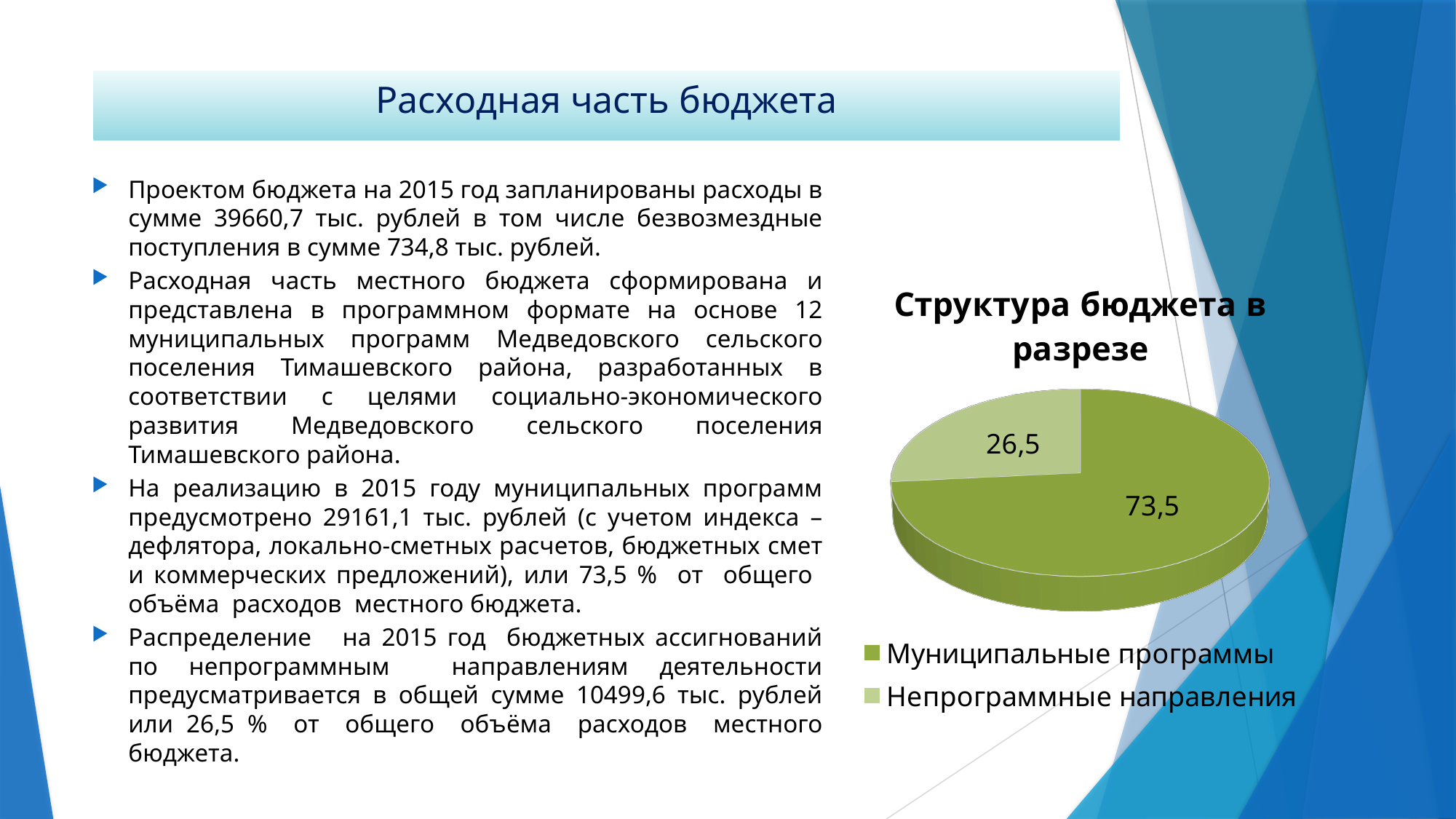
What value is shown for Непрограммные направления in the pie chart? 26,5 Which is larger: Муниципальные программы or Непрограммные направления? Муниципальные программы Which slice of the pie chart is the largest? Муниципальные программы What is the title of the chart? Структура бюджета в разрезе What type of chart is shown on the slide? Pie chart What is the total of the two values shown in the pie chart? 100 How many slices does the pie chart have? 2 Which slice of the pie chart is the smallest? Непрограммные направления What value is shown for Муниципальные программы in the pie chart? 73,5 Which legend entry is shown in the lighter green colour? Непрограммные направления How many entries does the chart legend list? 2 What is the difference between the values for Муниципальные программы and Непрограммные направления? 47